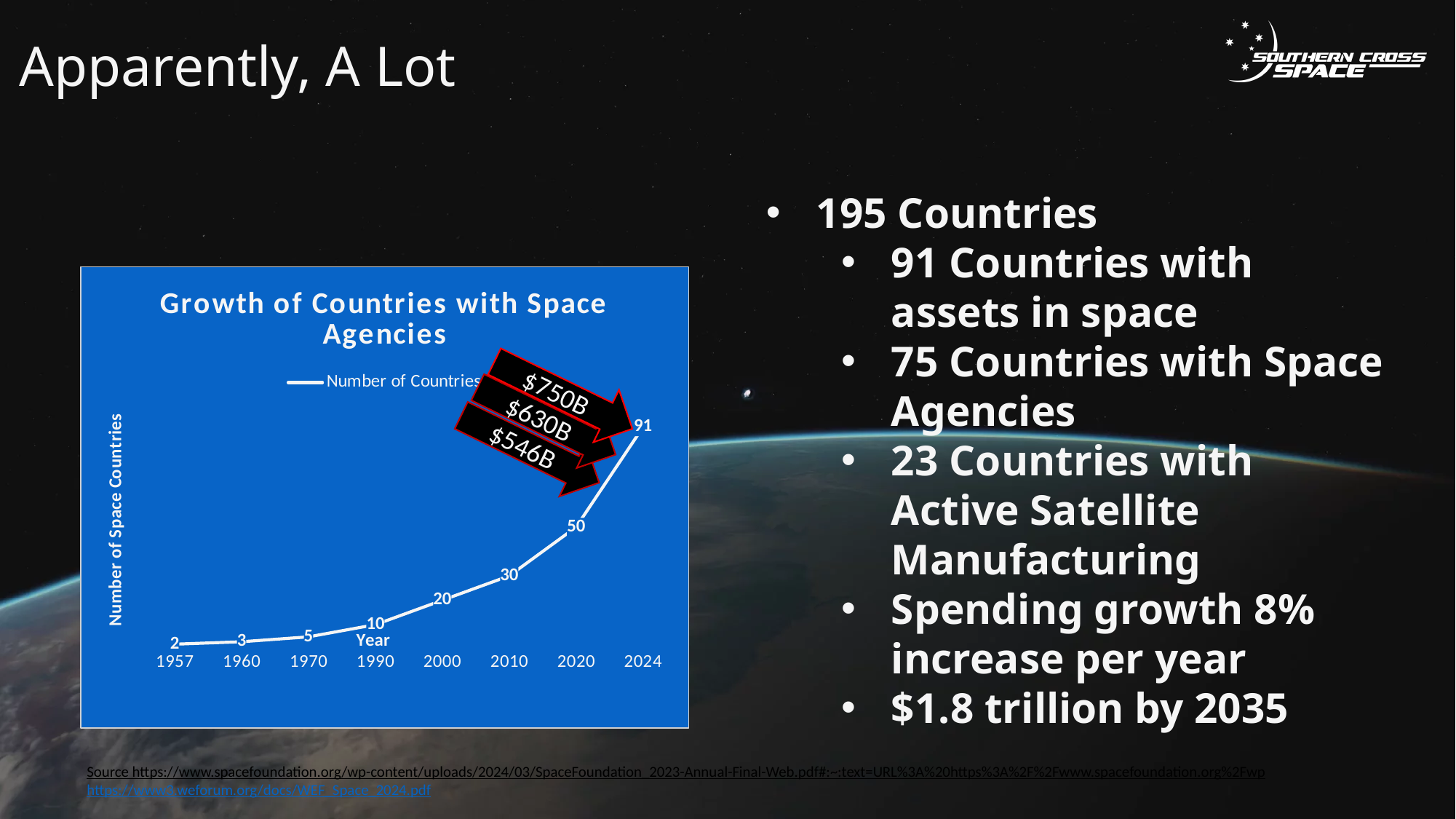
Which year has the highest number of countries? 2024 What type of chart is shown on the slide? line chart Does the number of countries rise or fall from 1957 to 2024? rise What is the number of countries plotted for 1957? 2 How many data points are plotted on the line? 8 What is the number of countries plotted for 2024? 91 Which year has a larger value, 1990 or 2000? 2000 What is the difference between the number of countries in 2024 and in 2020? 41 What is the title of the chart? Growth of Countries with Space Agencies Which year has the lowest number of countries? 1957 How many series does the legend list? 1 What is the number of countries plotted for 2010? 30